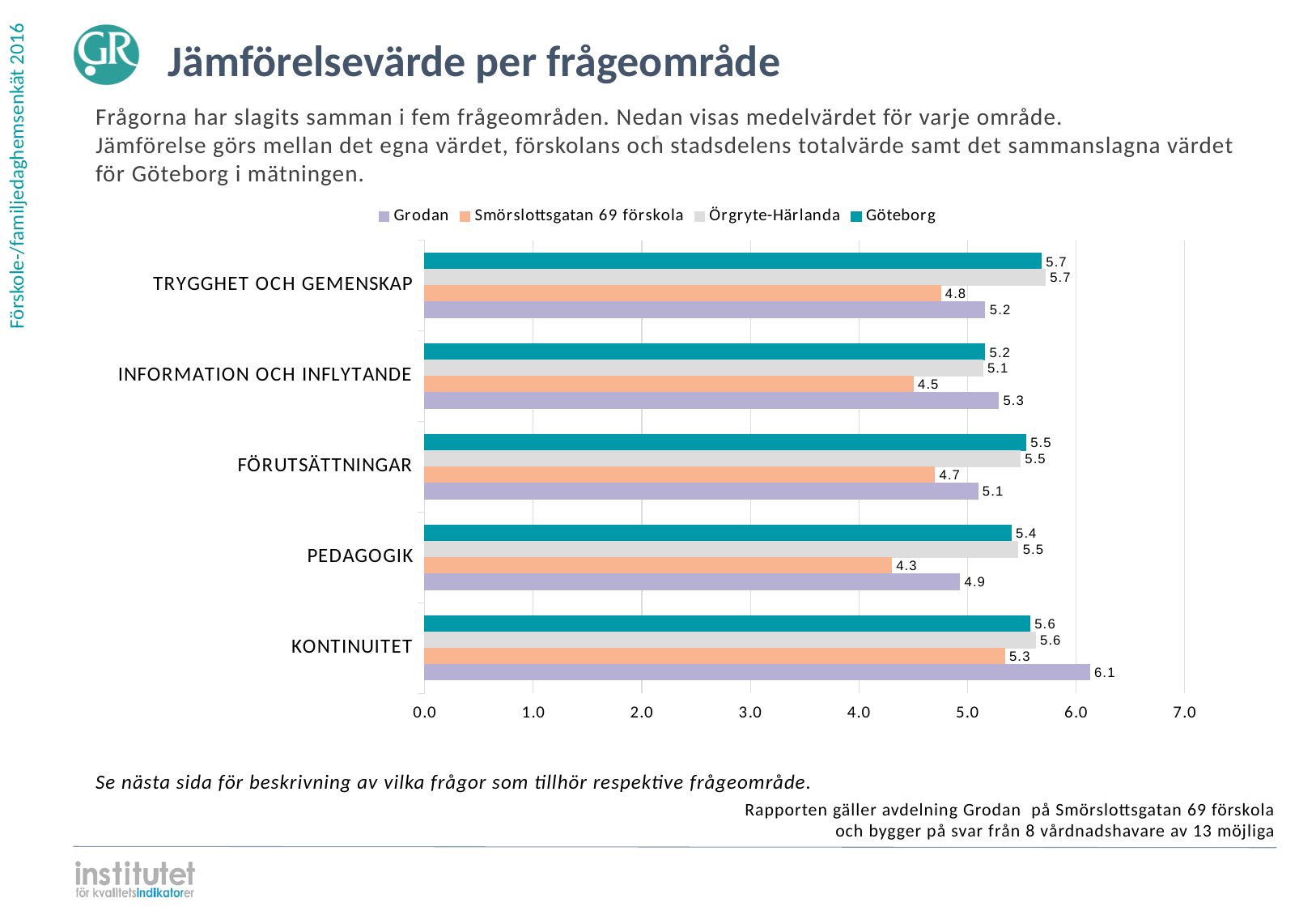
What is the difference between the Grodan value and the Smörslottsgatan 69 förskola value in KONTINUITET? 0.8 In which question area does Smörslottsgatan 69 förskola have its lowest value? PEDAGOGIK What kind of chart is shown on the slide? Bar chart In which question area does Grodan have its highest value? KONTINUITET What is the value for Grodan in KONTINUITET? 6.1 How many series does the legend list? 4 Which series is shown in orange in the legend? Smörslottsgatan 69 förskola In FÖRUTSÄTTNINGAR, which is larger: the value for Göteborg or the value for Grodan? Göteborg How many question areas (categories) are shown on the chart? 5 What is the value for Göteborg in INFORMATION OCH INFLYTANDE? 5.2 What is the value for Smörslottsgatan 69 förskola in PEDAGOGIK? 4.3 What is the value for Örgryte-Härlanda in TRYGGHET OCH GEMENSKAP? 5.7